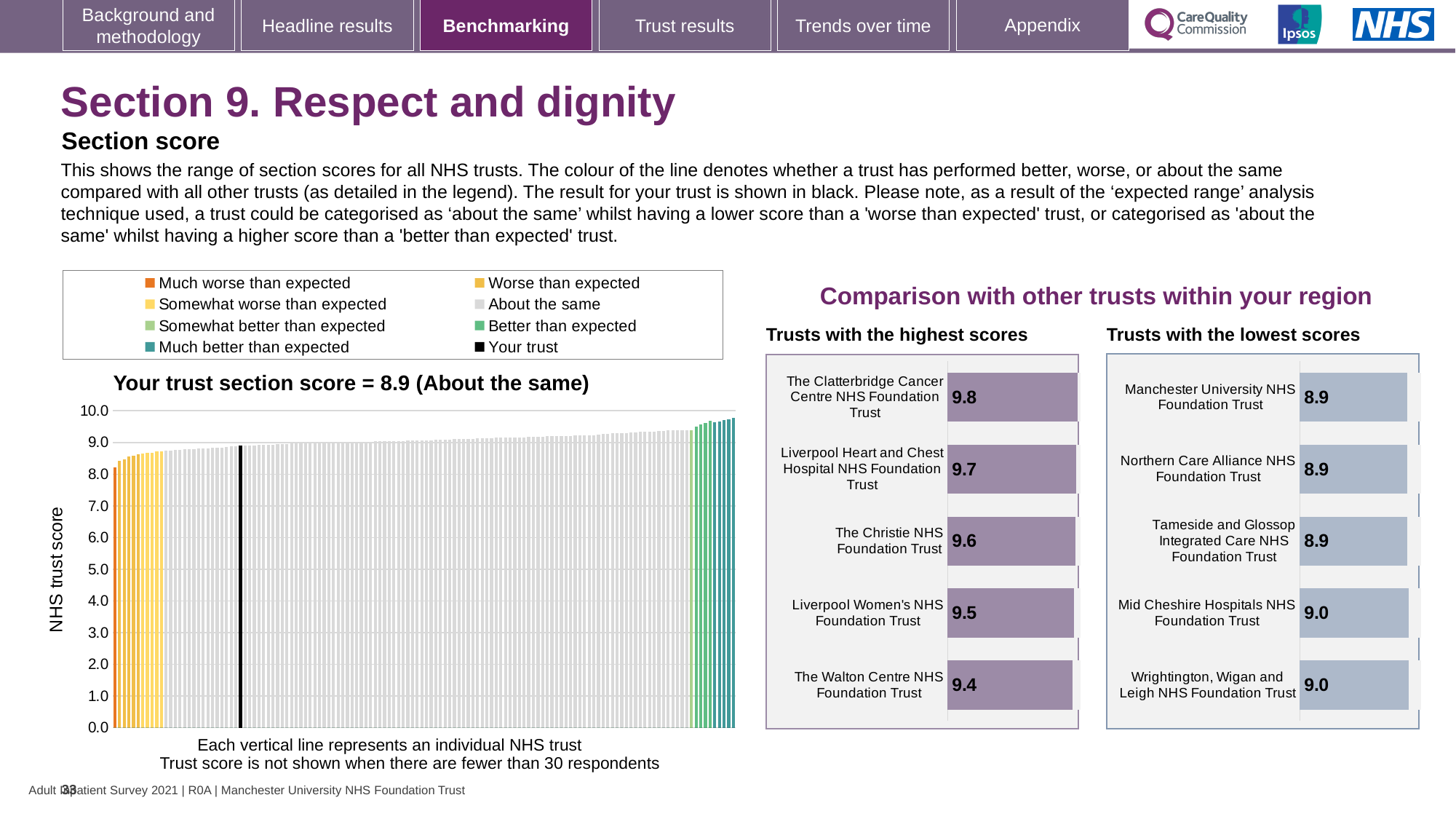
On the 'Trusts with the highest scores' chart, what is the difference between the scores of The Clatterbridge Cancer Centre NHS Foundation Trust and The Walton Centre NHS Foundation Trust? 0.4 On the 'Trusts with the highest scores' chart, which trust has the lowest score? The Walton Centre NHS Foundation Trust On the main chart 'Your trust section score', what is the section score for your trust? 8.9 On the 'Trusts with the highest scores' chart, which trust has the highest score? The Clatterbridge Cancer Centre NHS Foundation Trust On the 'Trusts with the highest scores' chart, what is the score for The Clatterbridge Cancer Centre NHS Foundation Trust? 9.8 What is the label on the vertical axis of the main section score chart? NHS trust score How many trusts are shown on the 'Trusts with the highest scores' chart? 5 On the main chart of section scores for all NHS trusts, do the values rise or fall from left to right along the x axis? rise On the 'Trusts with the lowest scores' chart, what is the score for Mid Cheshire Hospitals NHS Foundation Trust? 9.0 How many entries does the legend above the main section score chart list? 8 On the 'Trusts with the lowest scores' chart, which has the larger score: Mid Cheshire Hospitals NHS Foundation Trust or Manchester University NHS Foundation Trust? Mid Cheshire Hospitals NHS Foundation Trust What kind of chart is the main chart showing the range of section scores for all NHS trusts? bar chart